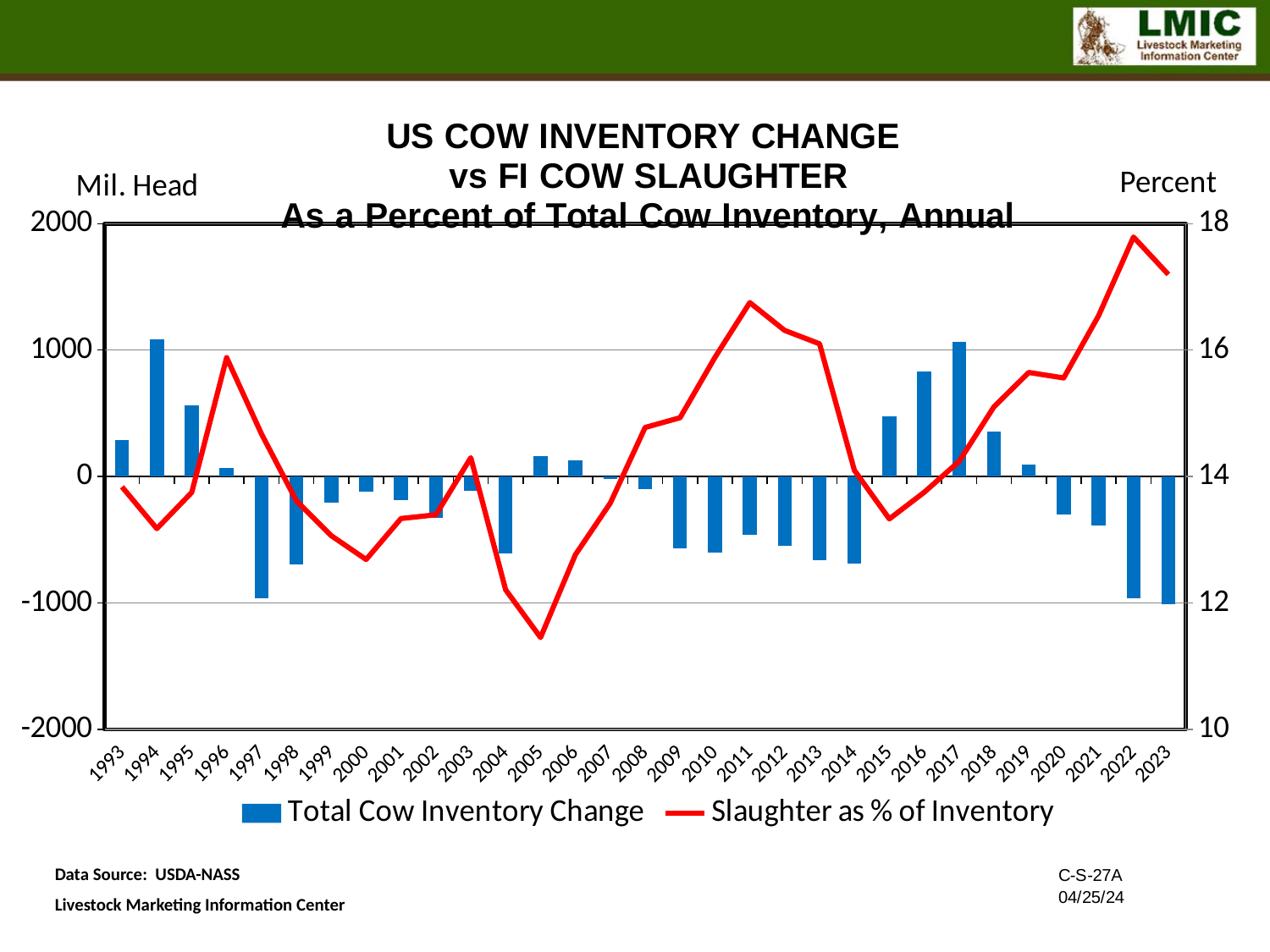
In which year does the Slaughter as % of Inventory line reach its lowest point? 2005 Does the Slaughter as % of Inventory line rise or fall from 2015 to 2022? rise Is the Slaughter as % of Inventory value for 2022 greater or less than 16? greater Which year has the higher Slaughter as % of Inventory value, 2009 or 2010? 2010 What is the label on the left vertical axis? Mil. Head Which year has the larger Total Cow Inventory Change bar, 2015 or 2016? 2016 Is the Slaughter as % of Inventory value for 2005 greater or less than 12? less Is the Total Cow Inventory Change bar for 1994 greater or less than 1000? greater How many years are shown on the x axis? 31 What kind of chart is shown on the slide? A combination bar and line chart In which year does the Slaughter as % of Inventory line reach its highest point? 2022 How many series does the legend list? 2